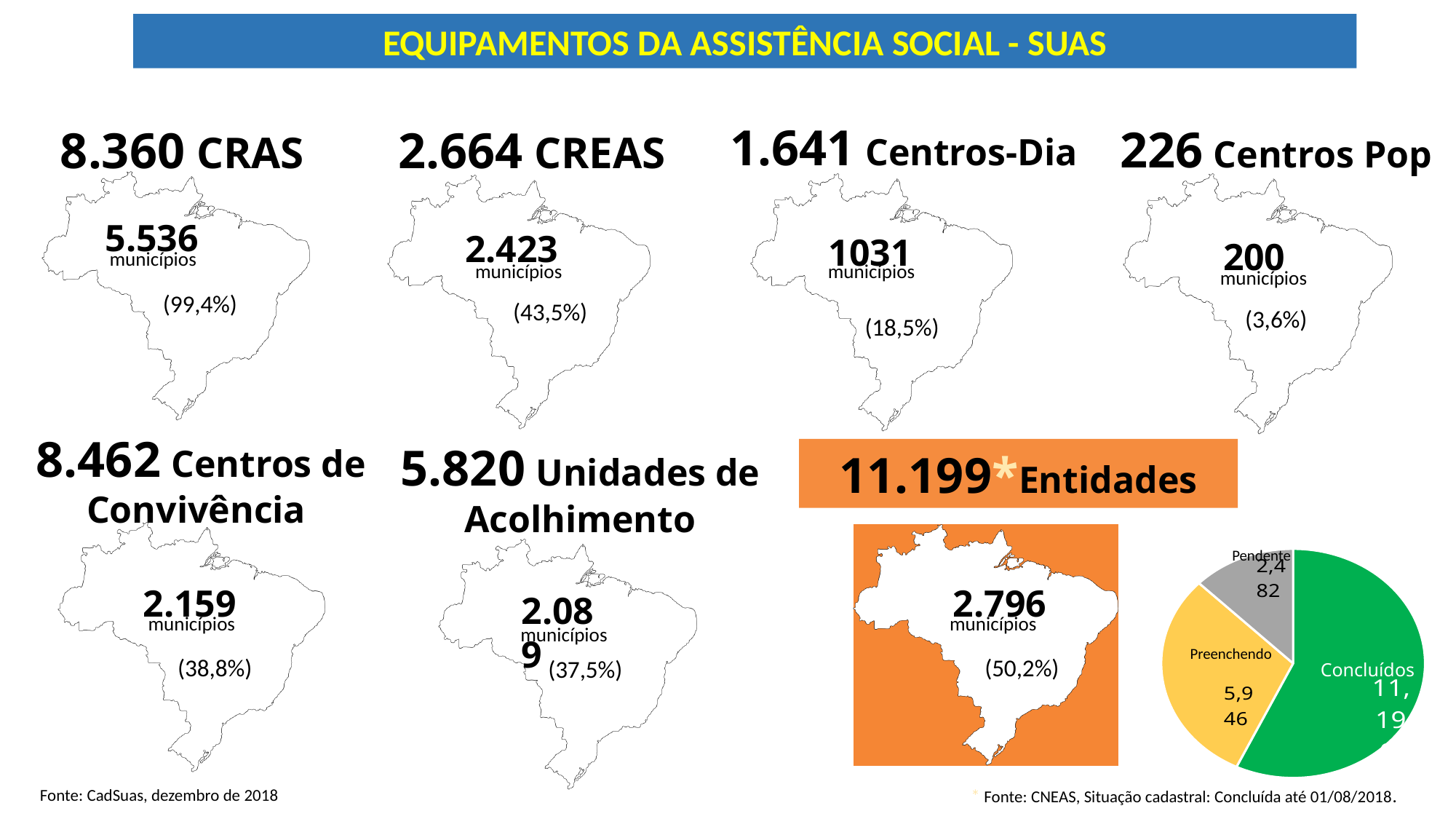
What colour is the Pendente slice in the pie chart? grey What colour is the Concluídos slice in the pie chart? green What kind of chart is shown at the bottom right of the slide? pie chart Which slice of the pie chart is the smallest? Pendente In the pie chart, what is the difference between the Preenchendo and Pendente values? 3,464 How many slices does the pie chart have? 3 What is the value shown for Pendente in the pie chart? 2,482 What is the value shown for Preenchendo in the pie chart? 5,946 Which slice of the pie chart is the largest? Concluídos In the pie chart, which is larger, Preenchendo or Pendente? Preenchendo